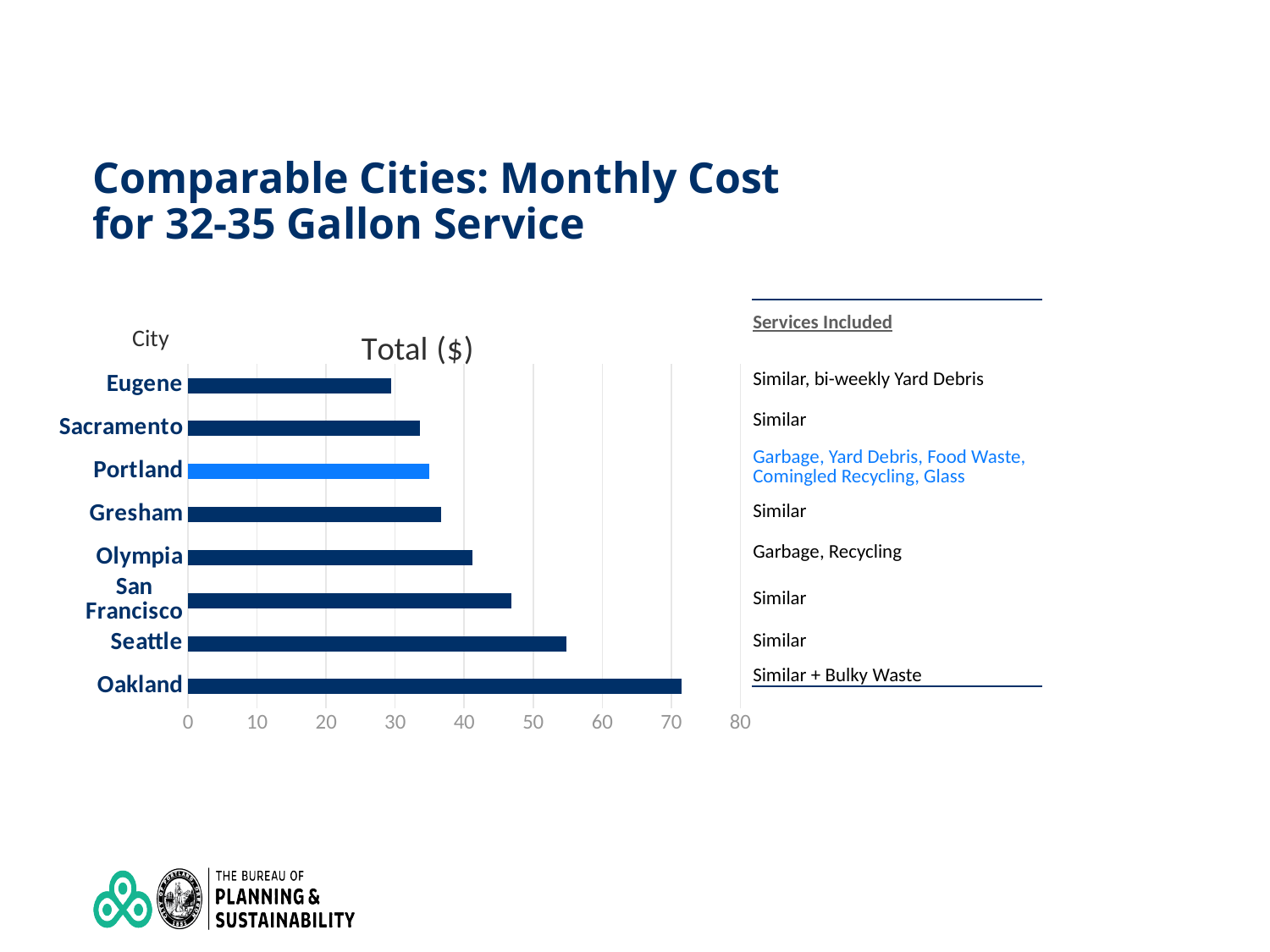
Is the value for San Francisco greater or less than 50? less Which city has the lowest monthly cost? Eugene Is the value for Eugene greater or less than 20? greater What kind of chart is shown on the slide? bar chart Is the value for Seattle greater or less than 50? greater Which city's bar is drawn in a lighter blue than the others? Portland Which has a higher monthly cost, Seattle or San Francisco? Seattle Which city has the highest monthly cost? Oakland How many cities are shown in the chart? 8 Which has a higher monthly cost, Olympia or Gresham? Olympia